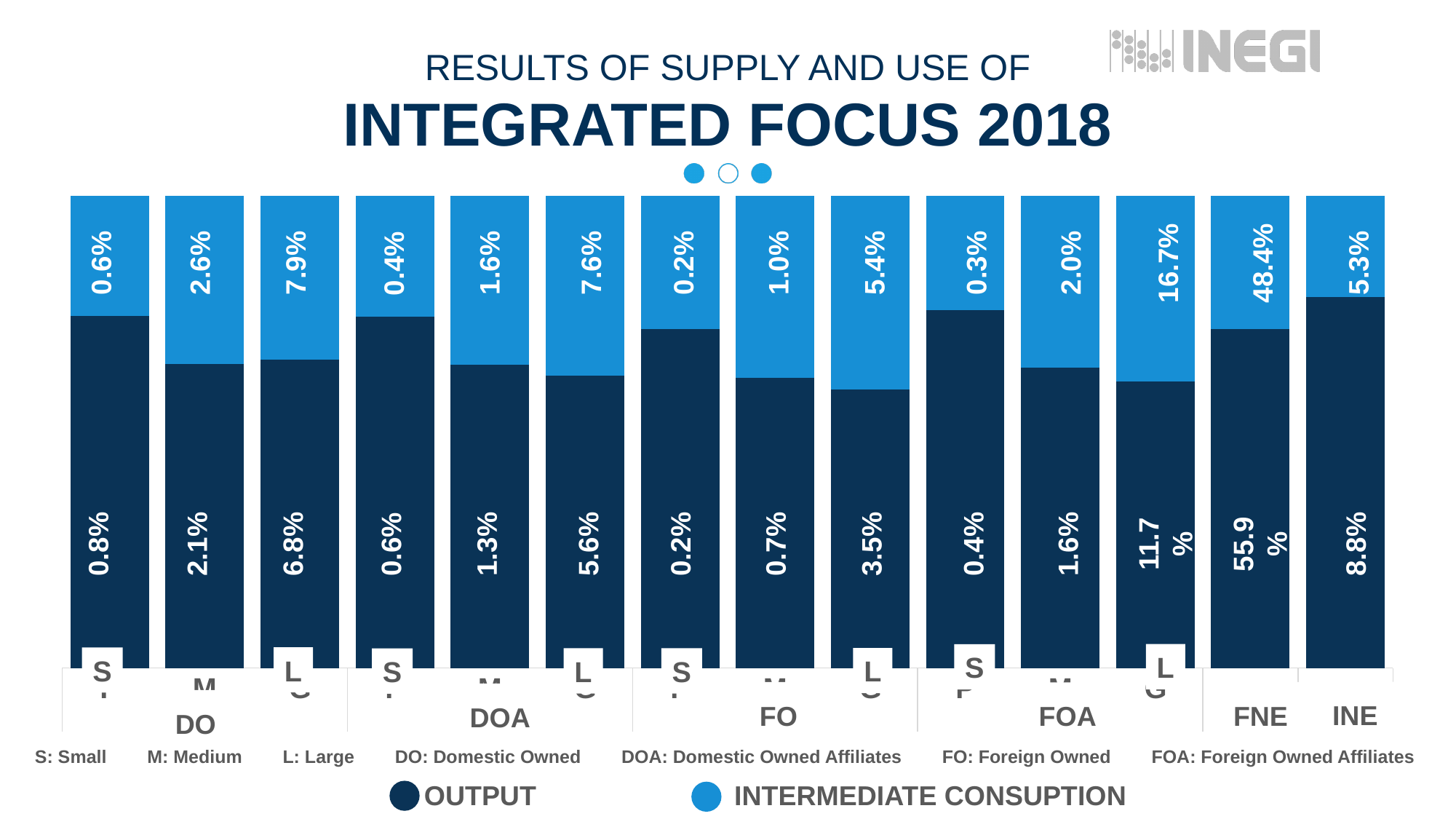
What is the difference between the OUTPUT values for FNE and INE? 47.1% Which category has the highest OUTPUT value? FNE What kind of chart is shown on the slide? Stacked bar chart Which is larger, the OUTPUT value for the Large (L) group under DO or the Large (L) group under DOA? Large (L) under DO What is the OUTPUT value for FNE? 55.9% What is the difference between the INTERMEDIATE CONSUPTION and OUTPUT values for the Large (L) group under FO? 1.9% How many bars are shown in the chart? 14 What is the INTERMEDIATE CONSUPTION value for INE? 5.3% What is the INTERMEDIATE CONSUPTION value for the Large (L) group under FOA? 16.7% Which category has the highest INTERMEDIATE CONSUPTION value? FNE How many series does the legend list? 2 What is the OUTPUT value for the Medium (M) group under DOA? 1.3%